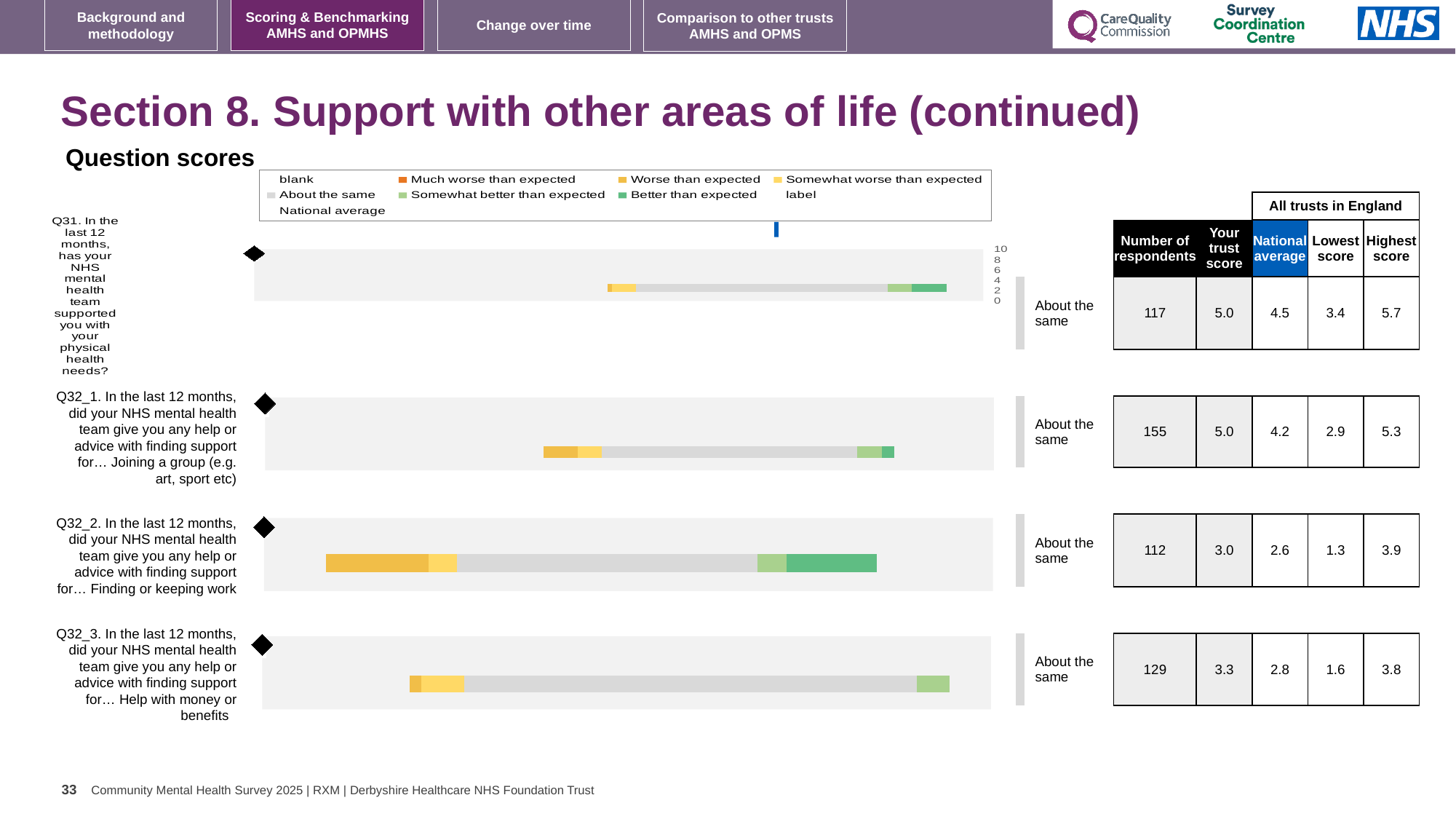
What is the highest score among all trusts in England for Q32_2 (finding or keeping work)? 3.9 What benchmark category label is shown next to each of the four bars? About the same Which has the higher national average: Q31 or Q32_1? Q31 How many questions (bars) are plotted on the slide? 4 What kind of chart is used to show the question scores on this slide? Bar chart Which question has the most respondents? Q32_1 (Joining a group) For Q32_2 (finding or keeping work), what is the trust's score? 3.0 For Q32_3 (help with money or benefits), what is the difference between the trust score and the national average? 0.5 Which question has the lowest 'Your trust score'? Q32_2 (Finding or keeping work) For Q31 (support with physical health needs), what is the number of respondents? 117 What colour does the legend use for 'Better than expected'? Green What is the lowest score among all trusts in England for Q32_1 (joining a group)? 2.9